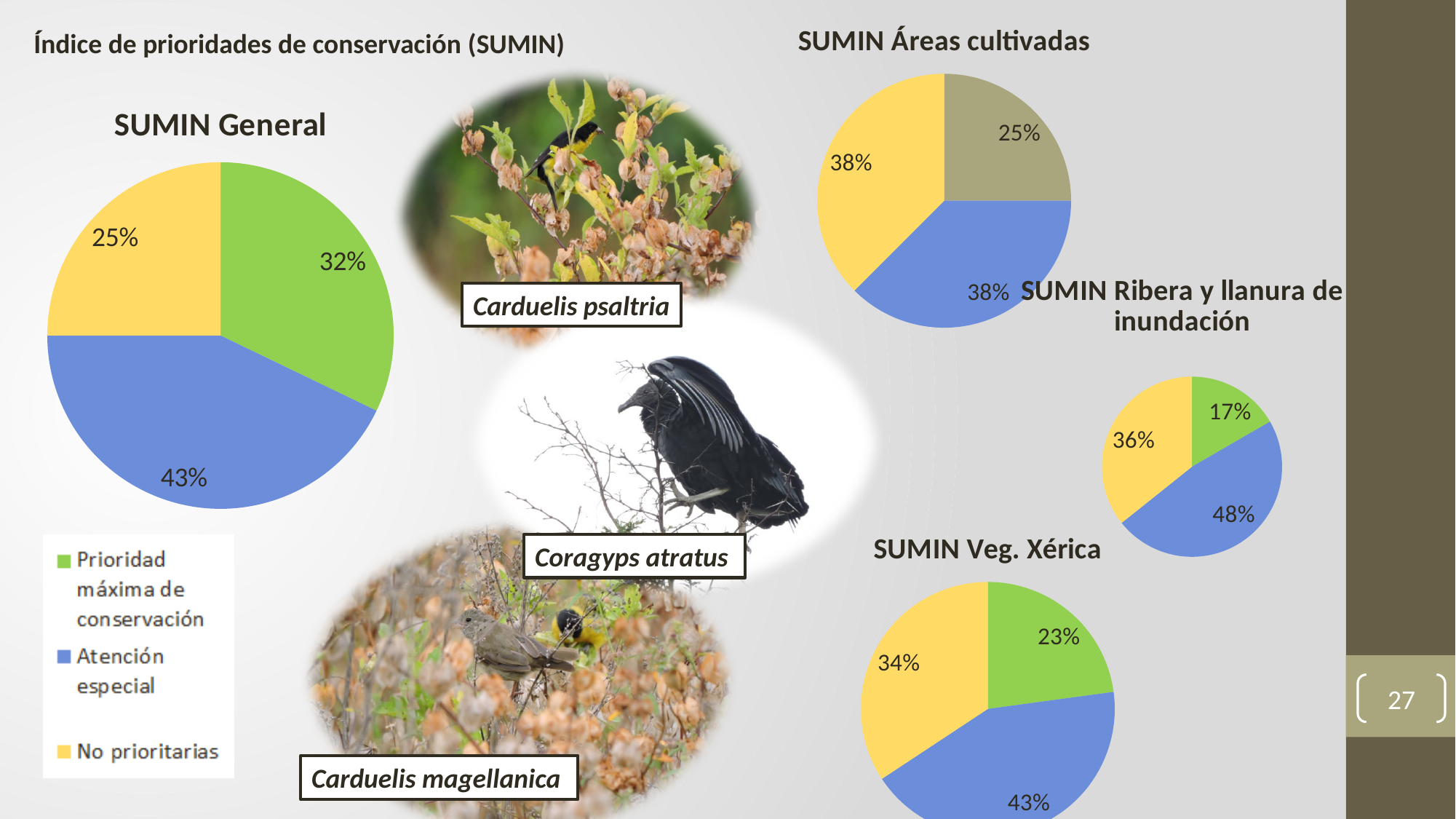
In the SUMIN Áreas cultivadas chart, which is larger: the 25% slice or the blue Atención especial slice? Atención especial How many categories does the legend list? 3 In the SUMIN Áreas cultivadas chart, what share is labelled for the yellow No prioritarias slice? 38% In the SUMIN Veg. Xérica chart, what share is labelled for No prioritarias (yellow)? 34% In the SUMIN Veg. Xérica chart, what is the difference between the Atención especial slice and the Prioridad máxima de conservación slice? 20% What kind of chart is the SUMIN General chart? pie chart In the SUMIN General chart, which category has the smallest slice? No prioritarias In the SUMIN Ribera y llanura de inundación chart, what share is labelled for Atención especial (blue)? 48% How many pie charts are shown on the slide? 4 In the SUMIN Ribera y llanura de inundación chart, which category has the smallest slice? Prioridad máxima de conservación